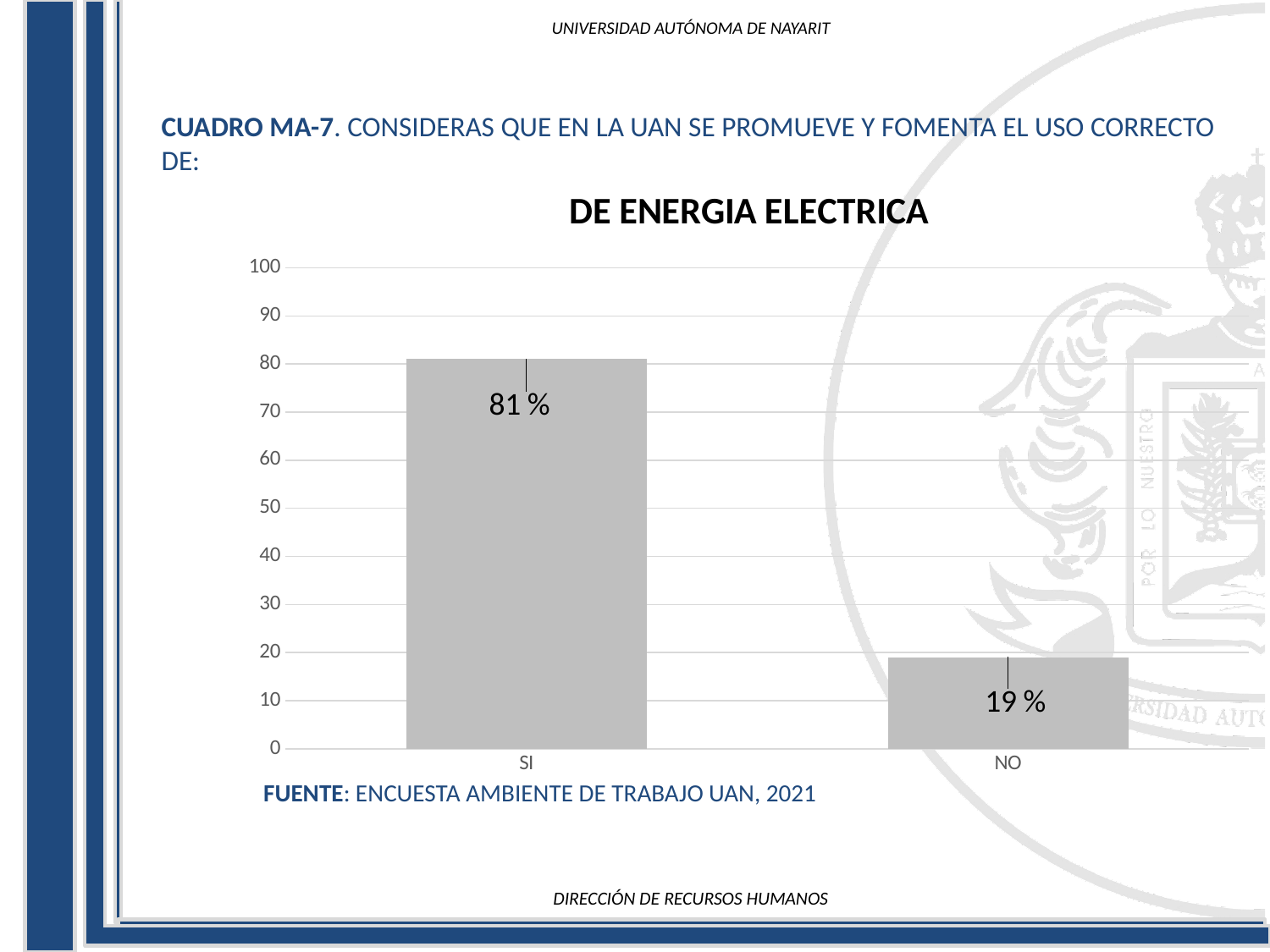
What is the highest value shown on the vertical axis? 100 What kind of chart is shown on the slide? bar chart Which category has the highest value? SI Is the value for SI greater or less than 50? greater Which is larger, the value for SI or the value for NO? SI What is the title of the chart? DE ENERGIA ELECTRICA How many categories are shown on the x axis? 2 What is the value for SI? 81 % Is the value for NO greater or less than 30? less What is the value for NO? 19 % Which category has the lowest value? NO What is the difference between the values for SI and NO? 62 %